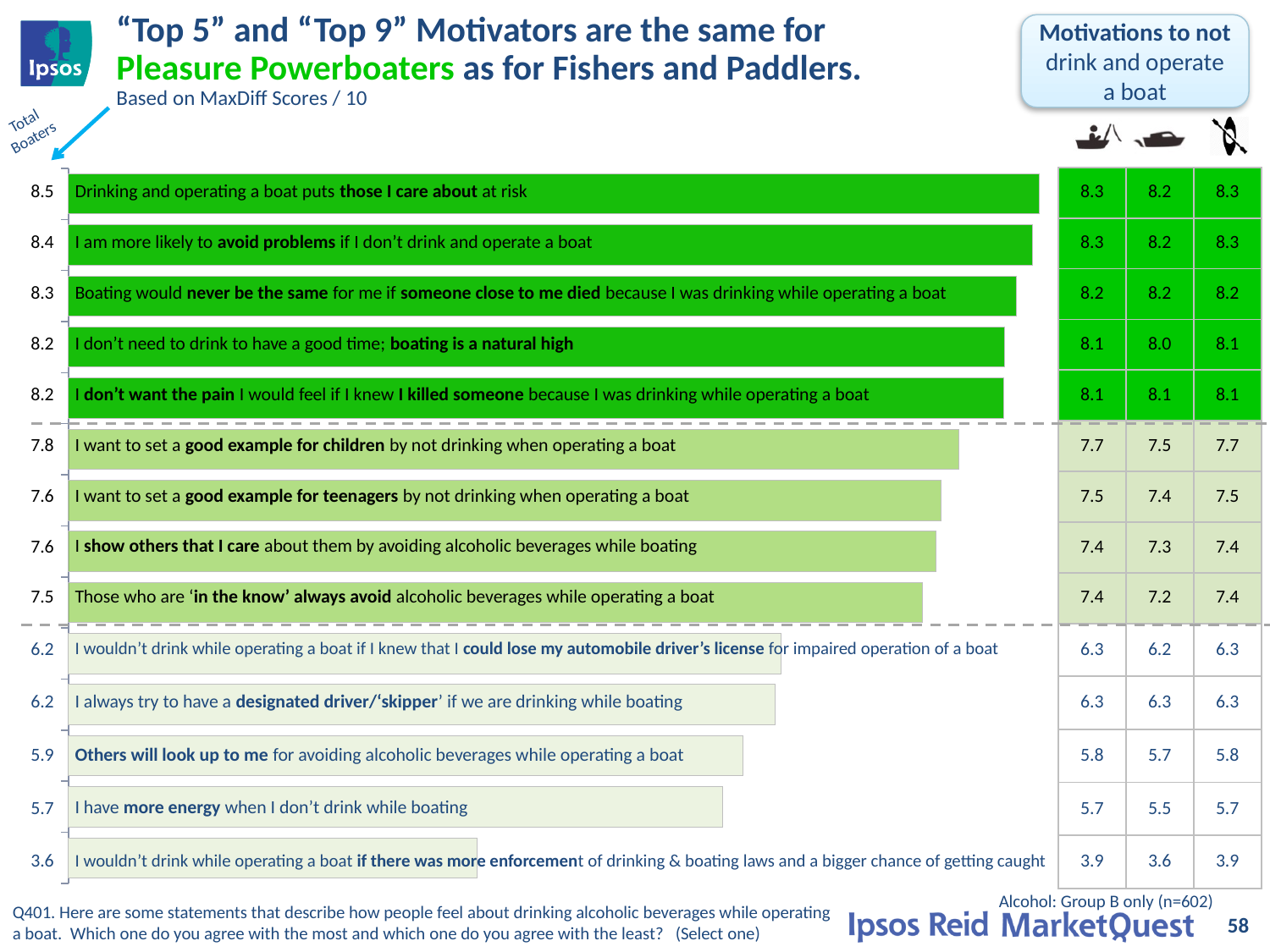
Do the Total Boaters scores rise or fall going from the top bar to the bottom bar? Fall What is the Total Boaters score for "I have more energy when I don't drink while boating"? 5.7 Which statement has the highest Total Boaters score? Drinking and operating a boat puts those I care about at risk How many statements (bars) are shown in the chart? 14 What is the Total Boaters score for "Drinking and operating a boat puts those I care about at risk"? 8.5 What is the difference between the highest Total Boaters score (8.5) and the lowest (3.6)? 4.9 Which statement has the lowest Total Boaters score? I wouldn't drink while operating a boat if there was more enforcement of drinking & boating laws and a bigger chance of getting caught What kind of chart is used to show the Total Boaters scores? Bar chart Which has a higher Total Boaters score: "I want to set a good example for children" or "Others will look up to me"? I want to set a good example for children According to the subtitle, what are the scores based on? MaxDiff Scores / 10 What is the difference between the Total Boaters scores for setting a good example for children and for teenagers? 0.2 What is the Total Boaters score for "I want to set a good example for teenagers by not drinking when operating a boat"? 7.6